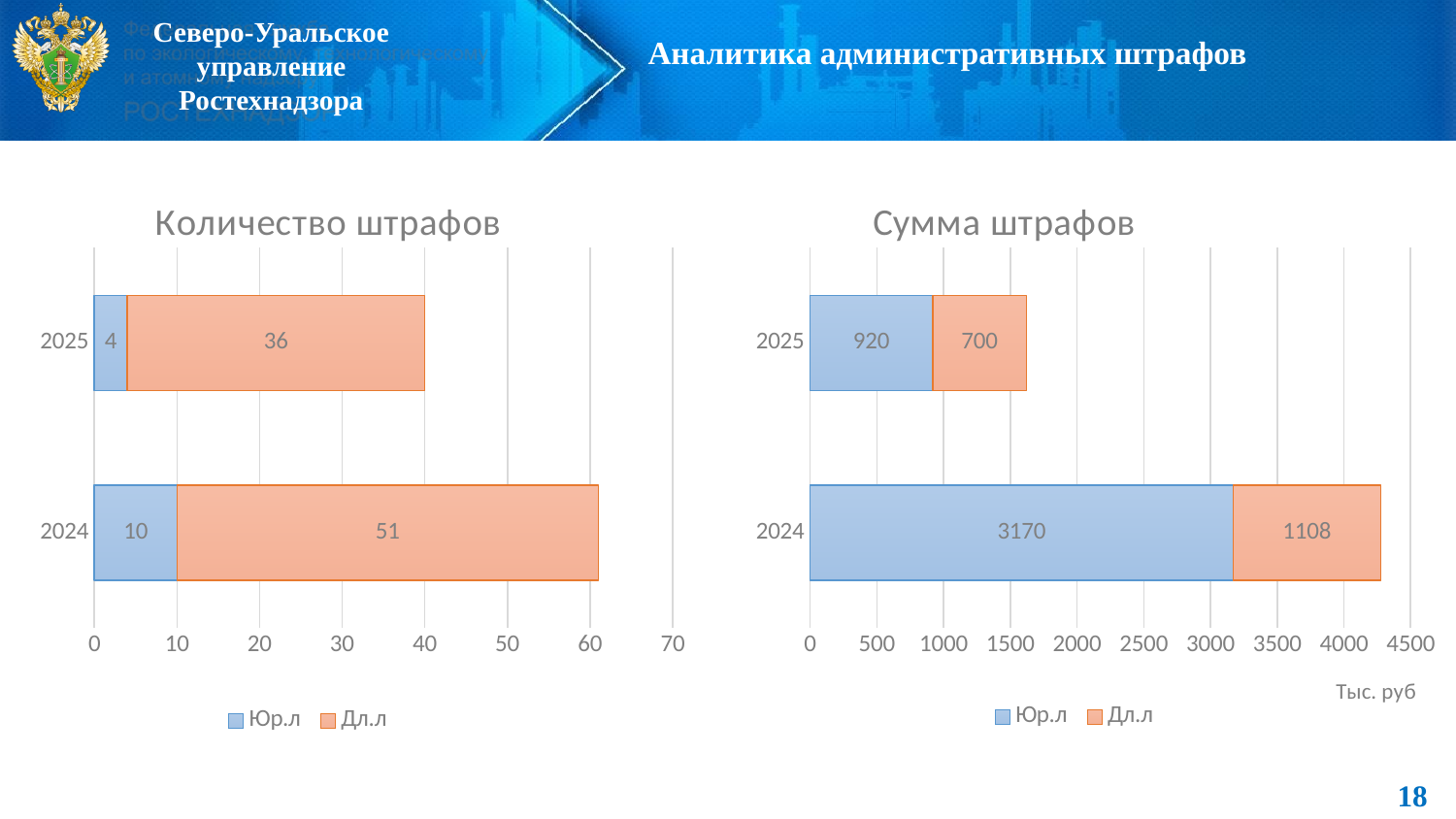
How many series does the legend of the 'Количество штрафов' chart list? 2 In the 'Количество штрафов' chart, what is the value for Дл.л in 2024? 51 In the 'Количество штрафов' chart, which year has the higher Дл.л value, 2024 or 2025? 2024 In the 'Количество штрафов' chart, what is the total of the stacked bar for 2024? 61 What kind of chart is the 'Сумма штрафов' chart? Stacked bar chart In the 'Сумма штрафов' chart, is the Юр.л value for 2024 greater or less than 3000? greater In the 'Сумма штрафов' chart, what is the value for Дл.л in 2025? 700 What unit is shown below the 'Сумма штрафов' chart? Тыс. руб In the 'Сумма штрафов' chart, what is the value for Юр.л in 2024? 3170 In the 'Сумма штрафов' chart, what is the total of the stacked bar for 2025? 1620 In the 'Сумма штрафов' chart, what is the difference between the Юр.л values for 2024 and 2025? 2250 In the 'Количество штрафов' chart, what is the value for Юр.л in 2025? 4